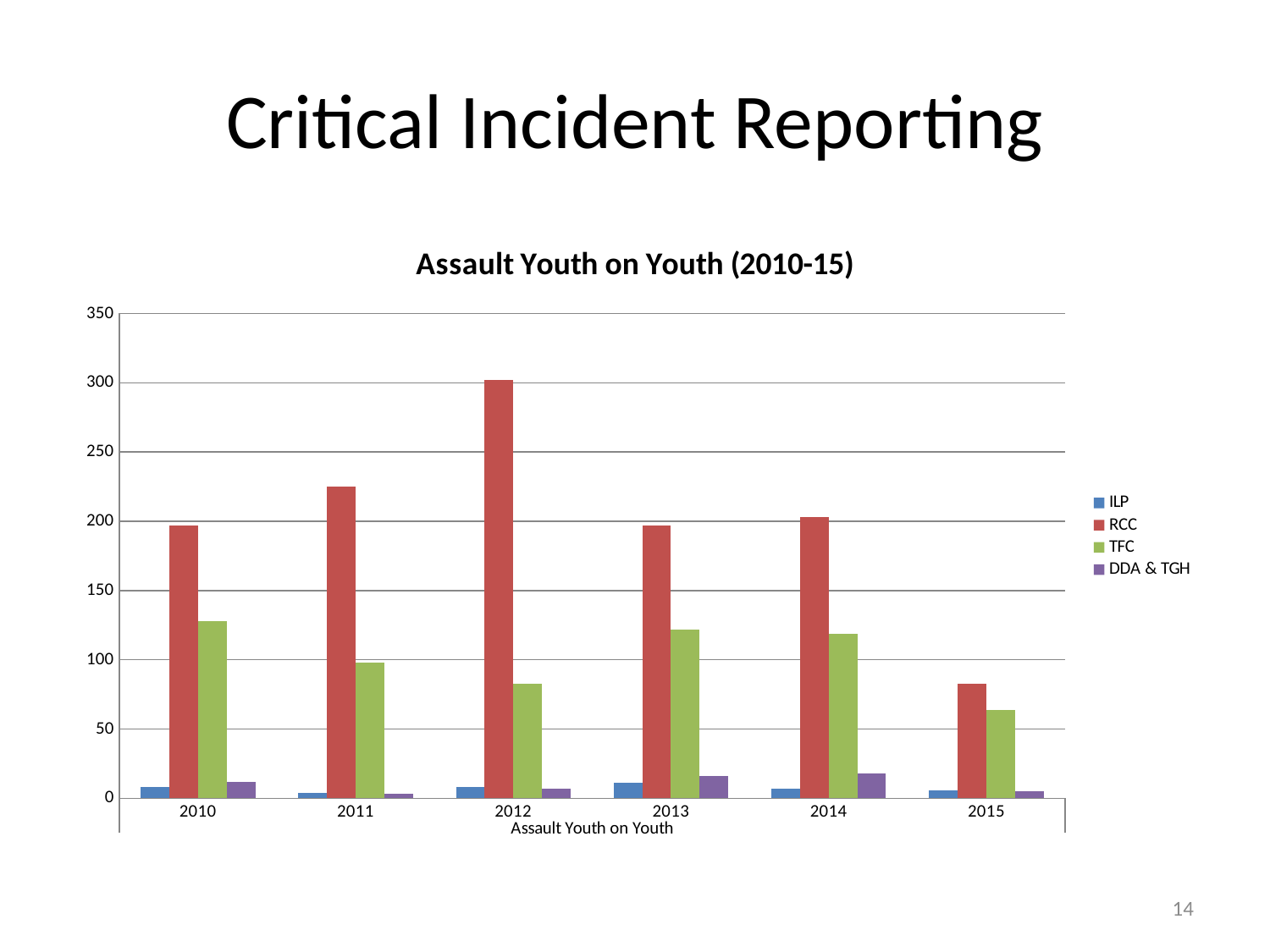
What is the title of the chart? Assault Youth on Youth (2010-15) In 2012, which is larger, the RCC value or the TFC value? RCC Is the RCC value for 2015 greater or less than 100? less In which year is the RCC value highest? 2012 Is the TFC value for 2010 greater or less than 100? greater How many series does the legend list? 4 In which year is the RCC value lowest? 2015 How many years are shown on the x axis? 6 What kind of chart is shown on the slide? bar chart Is the RCC value for 2012 greater or less than 250? greater In which year is the TFC value lowest? 2015 Which is larger, the TFC value for 2011 or the TFC value for 2012? 2011